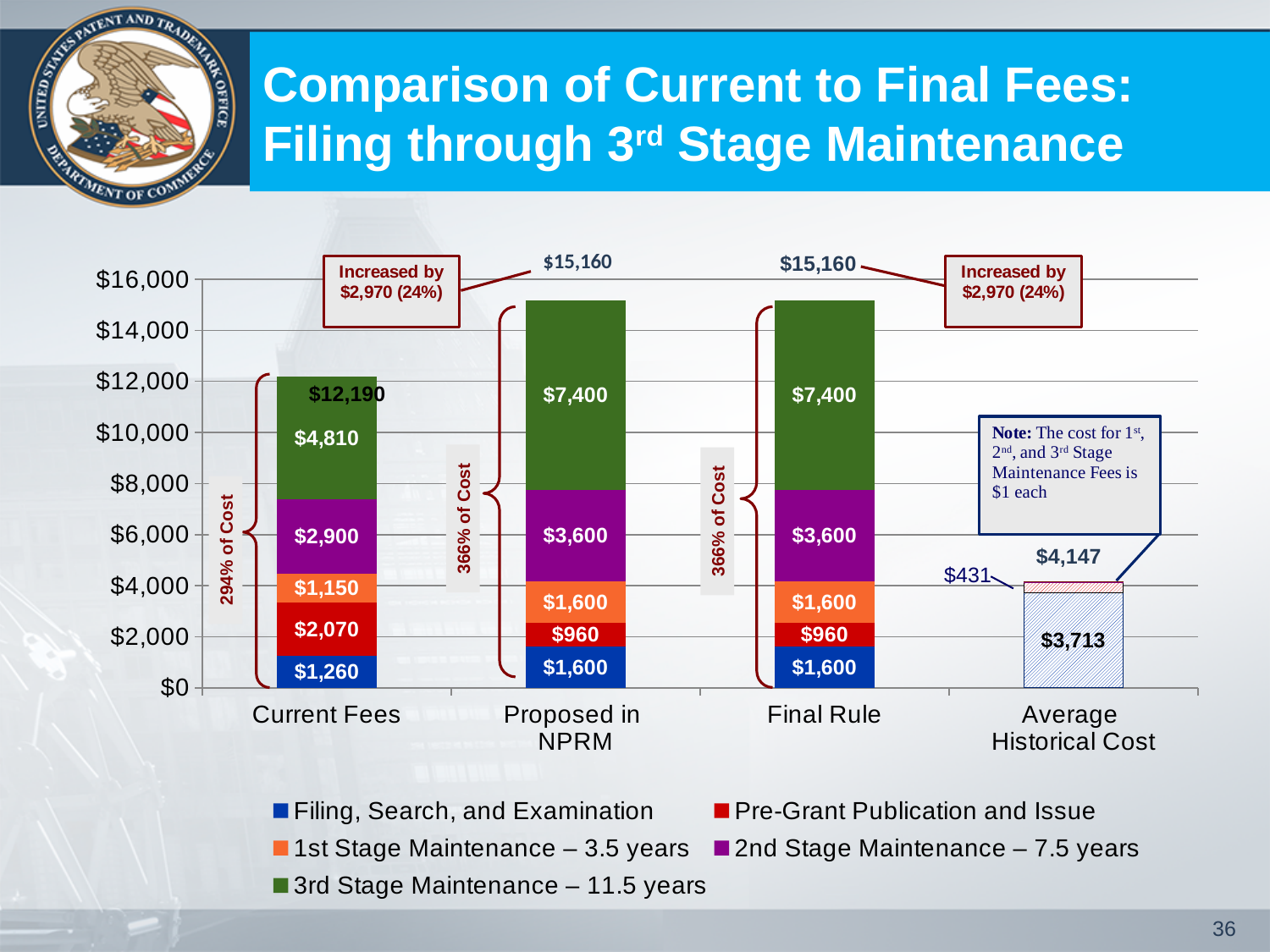
What is the value of 2nd Stage Maintenance – 7.5 years for Proposed in NPRM? $3,600 Which category has the lowest total? Average Historical Cost What kind of chart is shown on the slide? Stacked bar chart What is the difference between the Final Rule total and the Current Fees total? $2,970 What is the total of the Average Historical Cost bar? $4,147 Is the total for Current Fees greater or less than $14,000? less How many series does the legend list? 5 Which is larger for Filing, Search, and Examination: Current Fees or Final Rule? Final Rule What is the total of the Final Rule bar? $15,160 What is the difference between Pre-Grant Publication and Issue for Current Fees and for Final Rule? $1,110 What is the value of 3rd Stage Maintenance – 11.5 years for Current Fees? $4,810 How many categories are shown along the x axis? 4